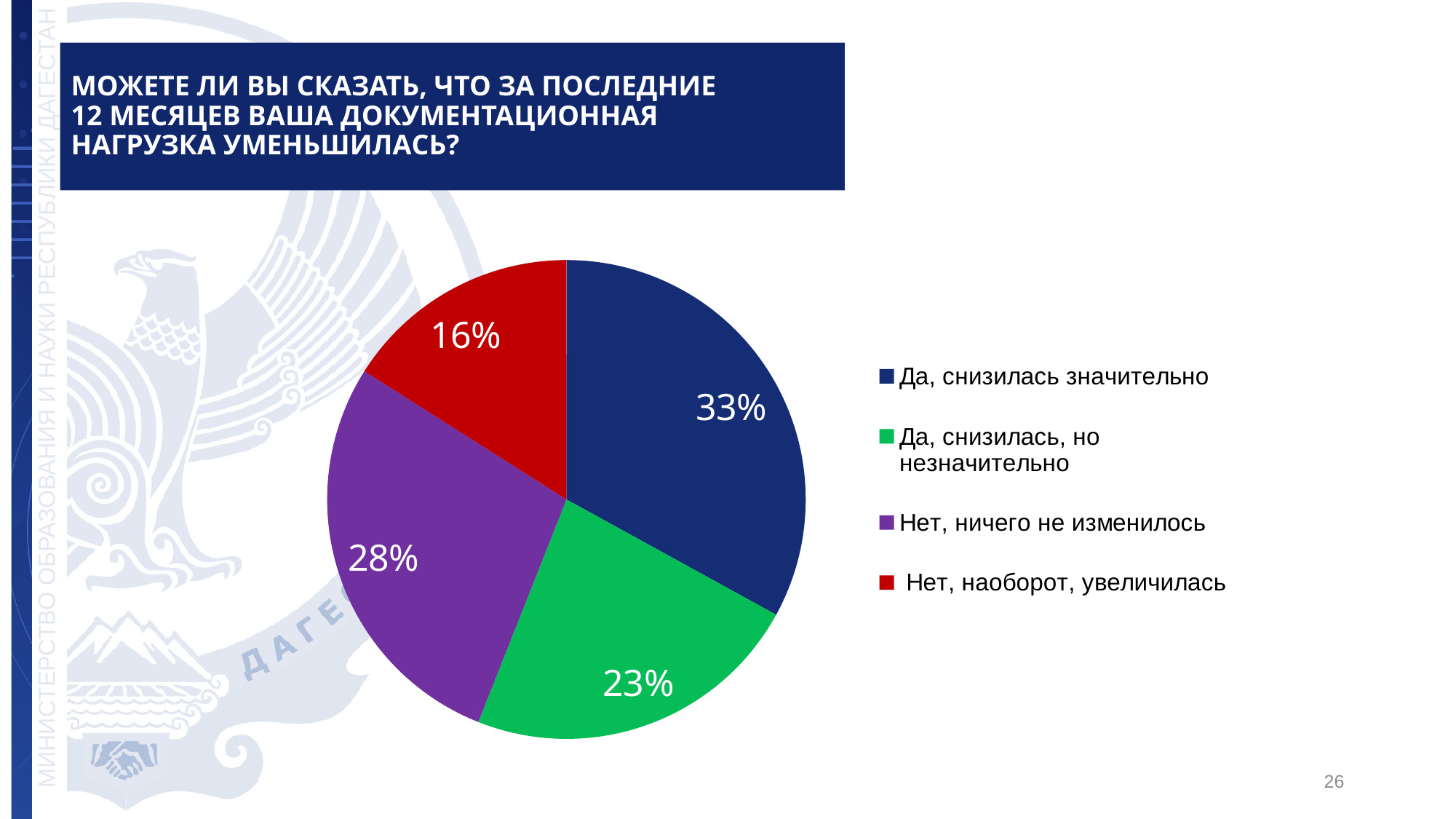
What share of the pie is labelled "Нет, ничего не изменилось"? 28% Which category has the largest slice of the pie? Да, снизилась значительно What share of the pie is labelled "Да, снизилась значительно"? 33% What kind of chart is shown on the slide? pie chart Which category has the smallest slice of the pie? Нет, наоборот, увеличилась What is the difference in percentage points between "Да, снизилась значительно" and "Нет, наоборот, увеличилась"? 17 What is the combined share of the two "Да" categories? 56% What share of the pie is labelled "Нет, наоборот, увеличилась"? 16% What colour is the slice for "Нет, ничего не изменилось"? purple What share of the pie is labelled "Да, снизилась, но незначительно"? 23% Which is larger: the slice for "Нет, ничего не изменилось" or the slice for "Да, снизилась, но незначительно"? Нет, ничего не изменилось How many slices does the pie chart have? 4